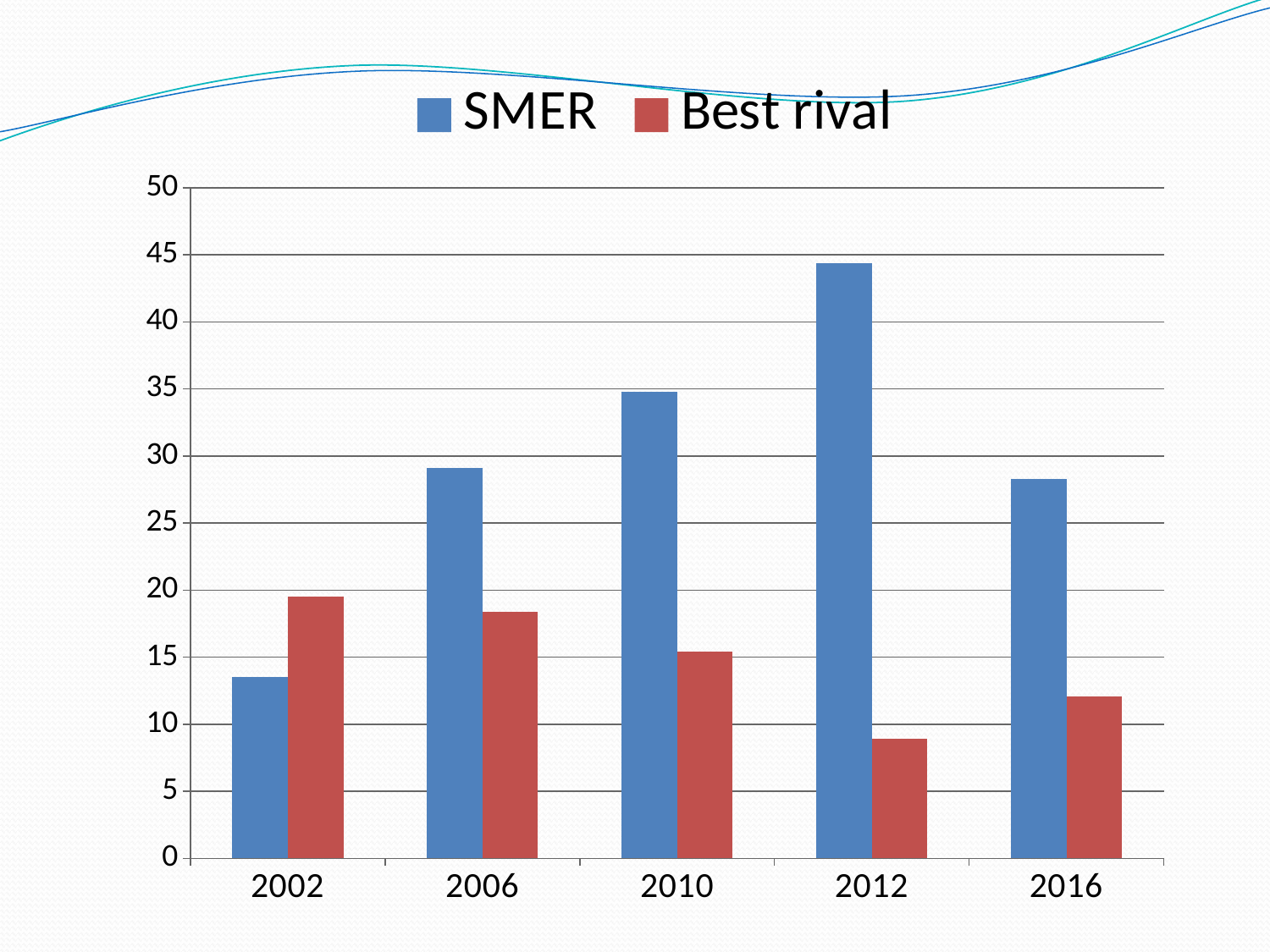
How many years are shown on the x axis? 5 In which year is the SMER value lowest? 2002 In which year is the Best rival value highest? 2002 In which year is the SMER value highest? 2012 Is the Best rival value for 2012 greater or less than 10? less In which year is the Best rival value lowest? 2012 In 2002, which is larger: SMER or Best rival? Best rival What kind of chart is shown on the slide? bar chart How many series does the legend list? 2 Does the SMER value rise or fall from 2002 to 2012? rise Is the SMER value for 2012 greater or less than 40? greater Which colour represents SMER in the legend? blue